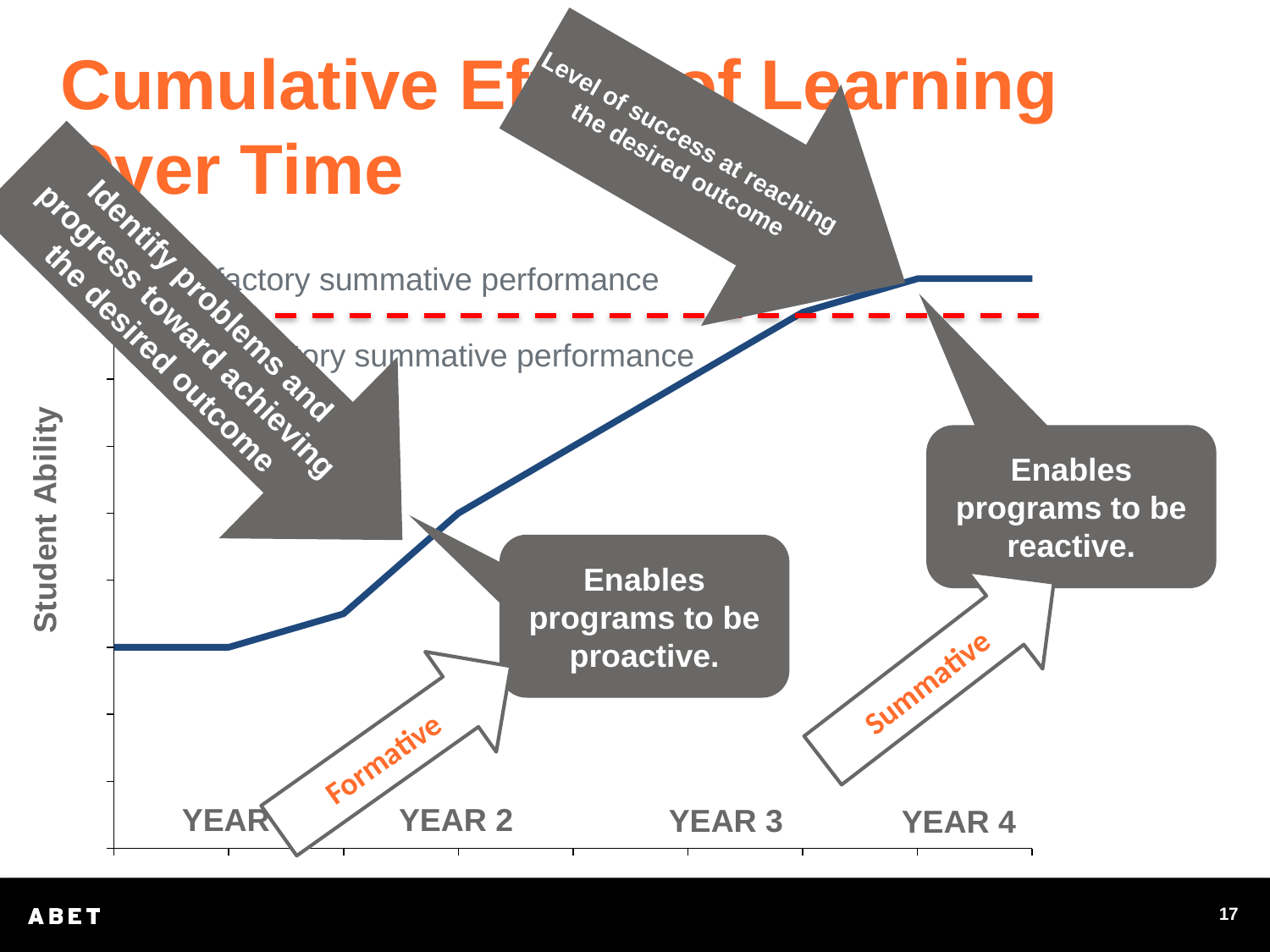
Is the plotted line above or below the red dashed line at YEAR 2? Below At which labelled year is the plotted line at its highest? YEAR 4 What is the label of the last category on the x axis? YEAR 4 Is the plotted line higher at YEAR 4 or at YEAR 2? YEAR 4 Does the plotted line rise or fall from YEAR 1 to YEAR 4? Rise What kind of chart is shown on the slide? Line chart How many year categories are labelled along the x axis of the chart? 4 Is the plotted line above or below the red dashed line at YEAR 4? Above What is the label on the vertical axis of the chart? Student Ability At which labelled year is the plotted line at its lowest? YEAR 1